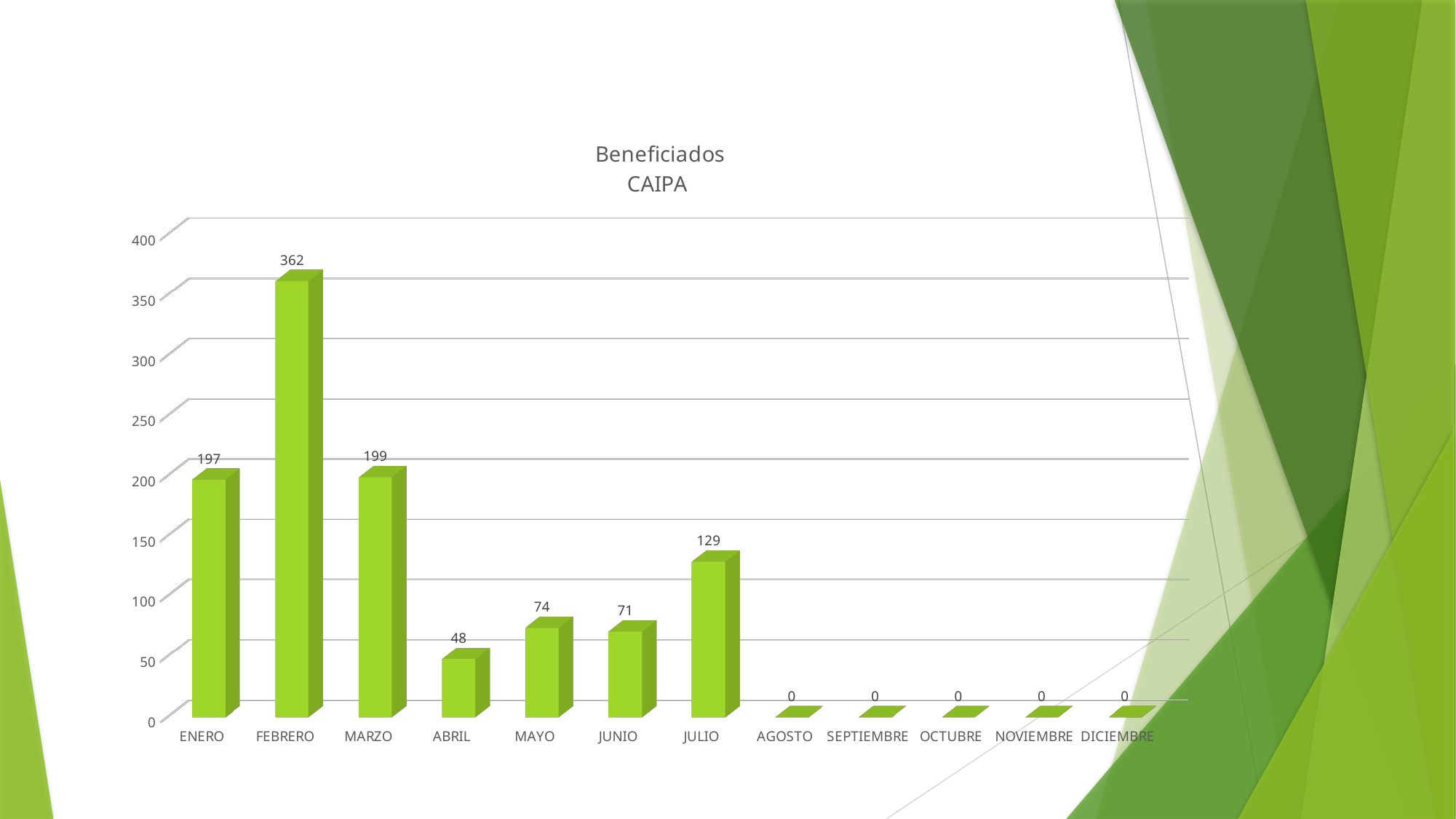
What kind of chart is shown? bar chart How many months have a value of 0? 5 What is the difference between the values for FEBRERO and MARZO? 163 Among the months with a non-zero value, which has the lowest value? ABRIL What is the value for FEBRERO? 362 What is the value for JULIO? 129 Which month has the highest value? FEBRERO What is the value for ABRIL? 48 What is the title of the chart? Beneficiados CAIPA Which is larger, the value for MAYO or the value for JUNIO? MAYO Is the value for ENERO greater or less than 150? greater How many months are shown on the x axis? 12